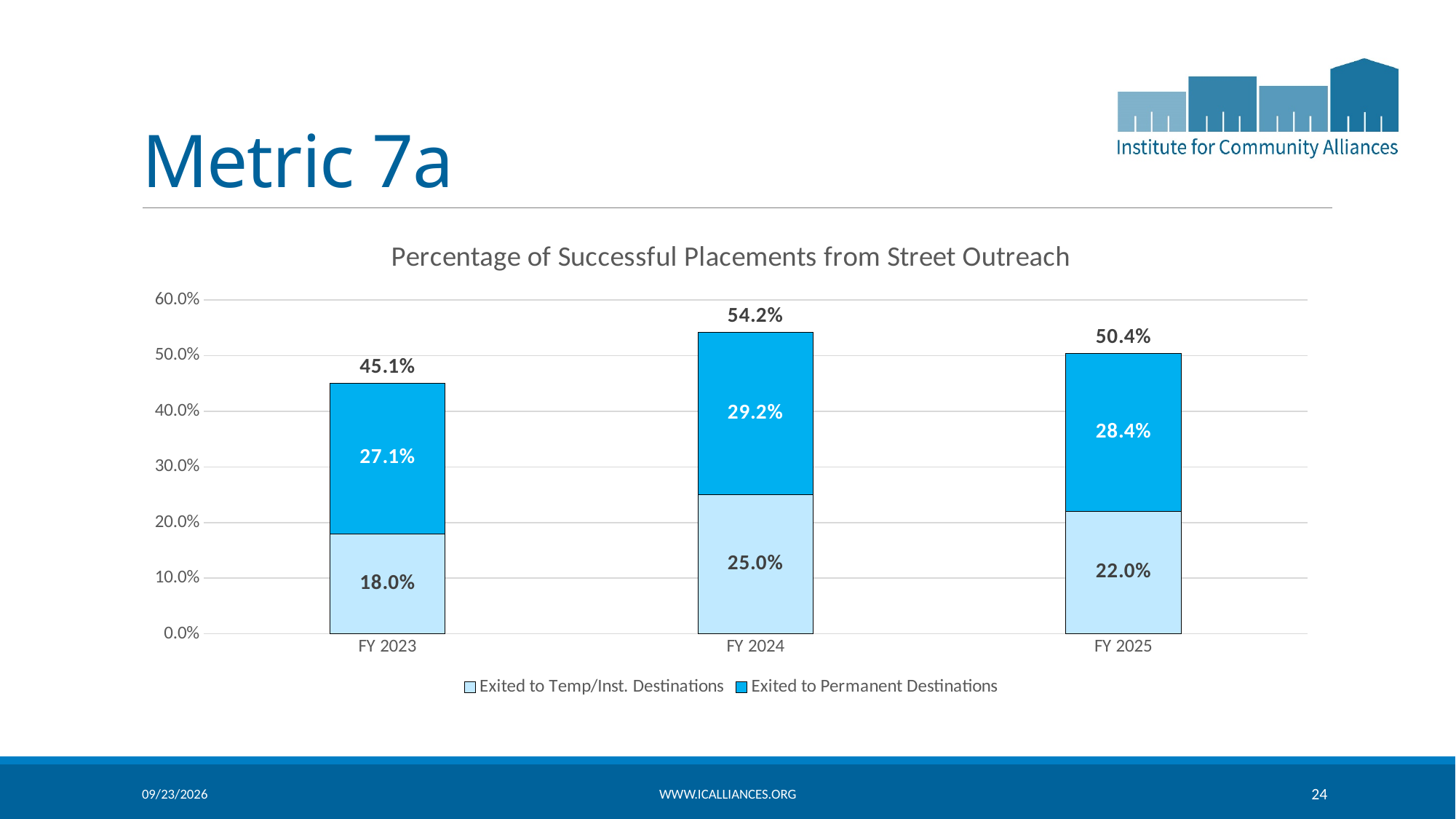
What is the value for Exited to Temp/Inst. Destinations in FY 2023? 18.0% What is the total of the stacked bar for FY 2024? 54.2% What is the title of the chart? Percentage of Successful Placements from Street Outreach What is the difference between the Exited to Permanent Destinations values for FY 2024 and FY 2023? 2.1% Which fiscal year has the lowest value for Exited to Temp/Inst. Destinations? FY 2023 How many fiscal years are shown on the x axis? 3 What is the value for Exited to Temp/Inst. Destinations in FY 2025? 22.0% Which is larger: Exited to Permanent Destinations in FY 2025 or Exited to Temp/Inst. Destinations in FY 2025? Exited to Permanent Destinations How many series does the legend list? 2 Which fiscal year has the highest total percentage of successful placements? FY 2024 What is the value for Exited to Permanent Destinations in FY 2024? 29.2% What kind of chart is shown on the slide? Stacked bar chart